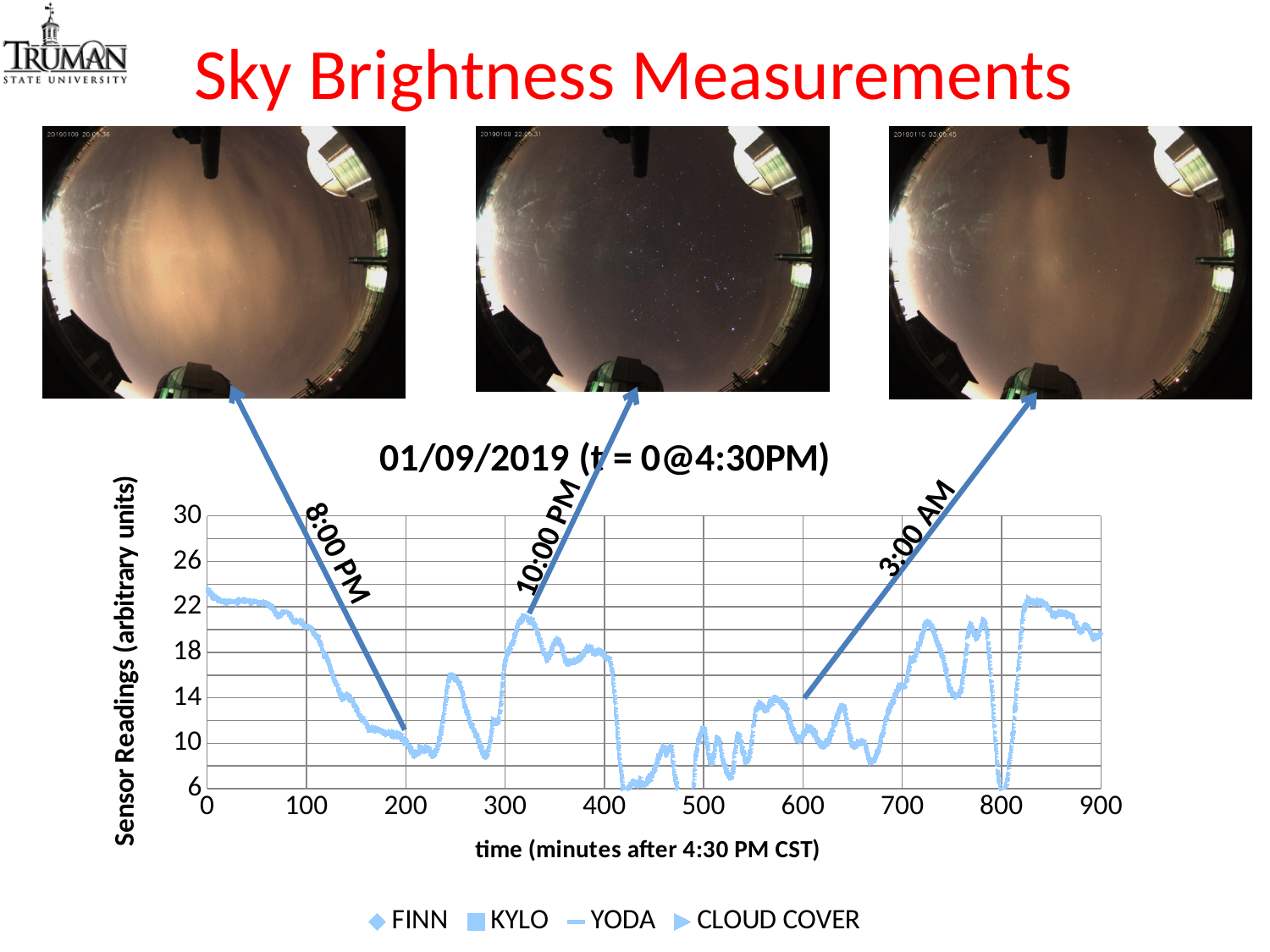
Is the sensor reading at time 900 greater or less than 14? greater Is the sensor reading at time 800 greater or less than 10? less Is the sensor reading at time 600 greater or less than 14? less Is the sensor reading at time 0 larger or smaller than the reading at time 200? larger What is the label of the chart's x axis? time (minutes after 4:30 PM CST) What is the title of the chart? 01/09/2019 (t = 0@4:30PM) What kind of chart is shown on the slide? line chart How many series does the chart legend list? 4 Do the sensor readings rise or fall between time 0 and time 200? fall